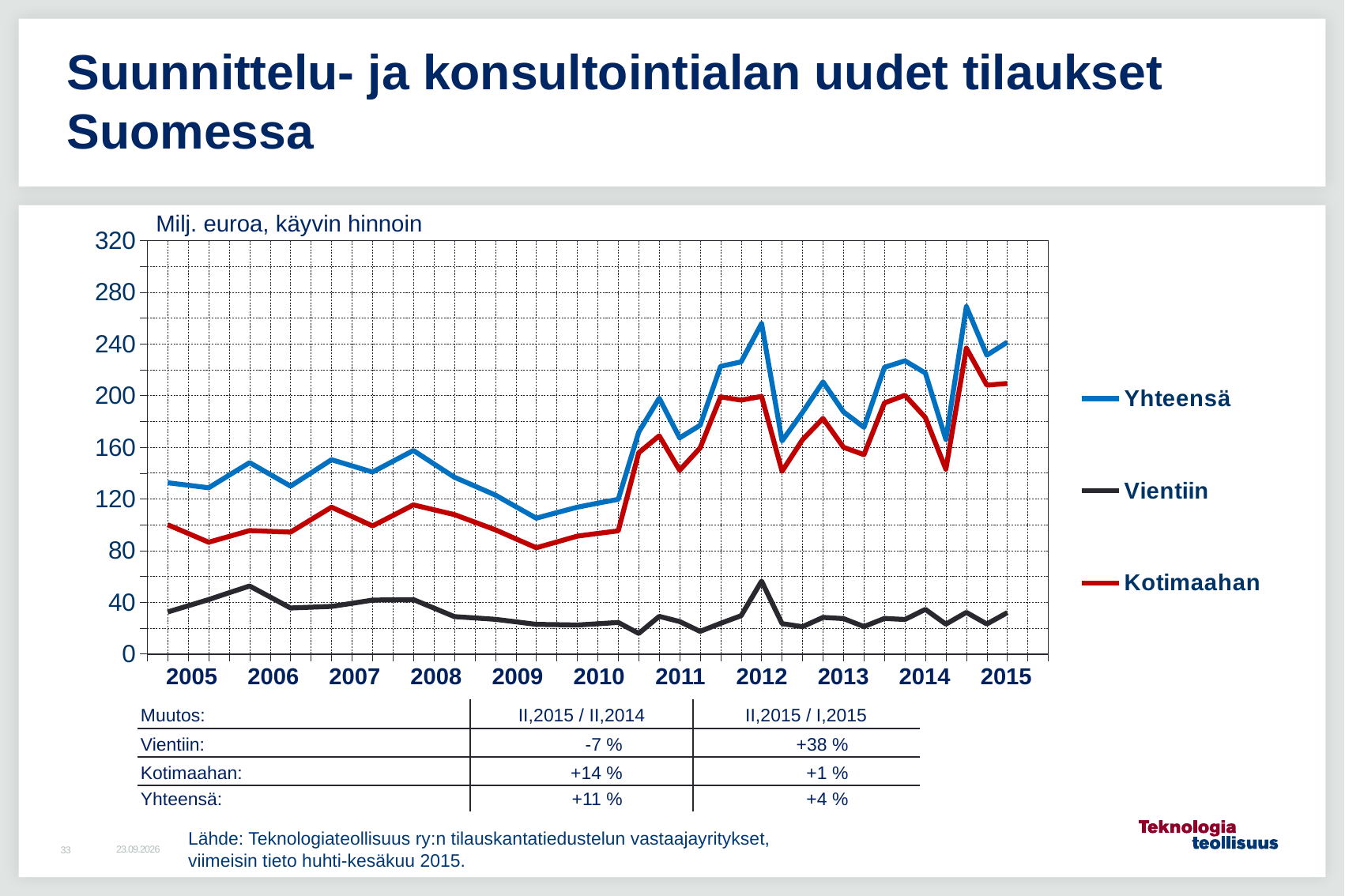
How many series does the legend list? 3 Is the peak value for Vientiin in 2012 greater or less than 40? greater What unit label is shown above the chart? Milj. euroa, käyvin hinnoin Does the Kotimaahan series rise or fall between 2010 and 2011? rise Which is larger in 2015, Kotimaahan or Vientiin? Kotimaahan Which series is plotted in red? Kotimaahan Which series has the lowest values throughout the chart? Vientiin How many years are labelled on the x axis? 11 Which series has the highest values throughout the chart? Yhteensä Is the value for Yhteensä at the start of 2005 greater or less than 120? greater What kind of chart is shown on the slide? line chart Is the highest value for Yhteensä in 2014 greater or less than 280? less